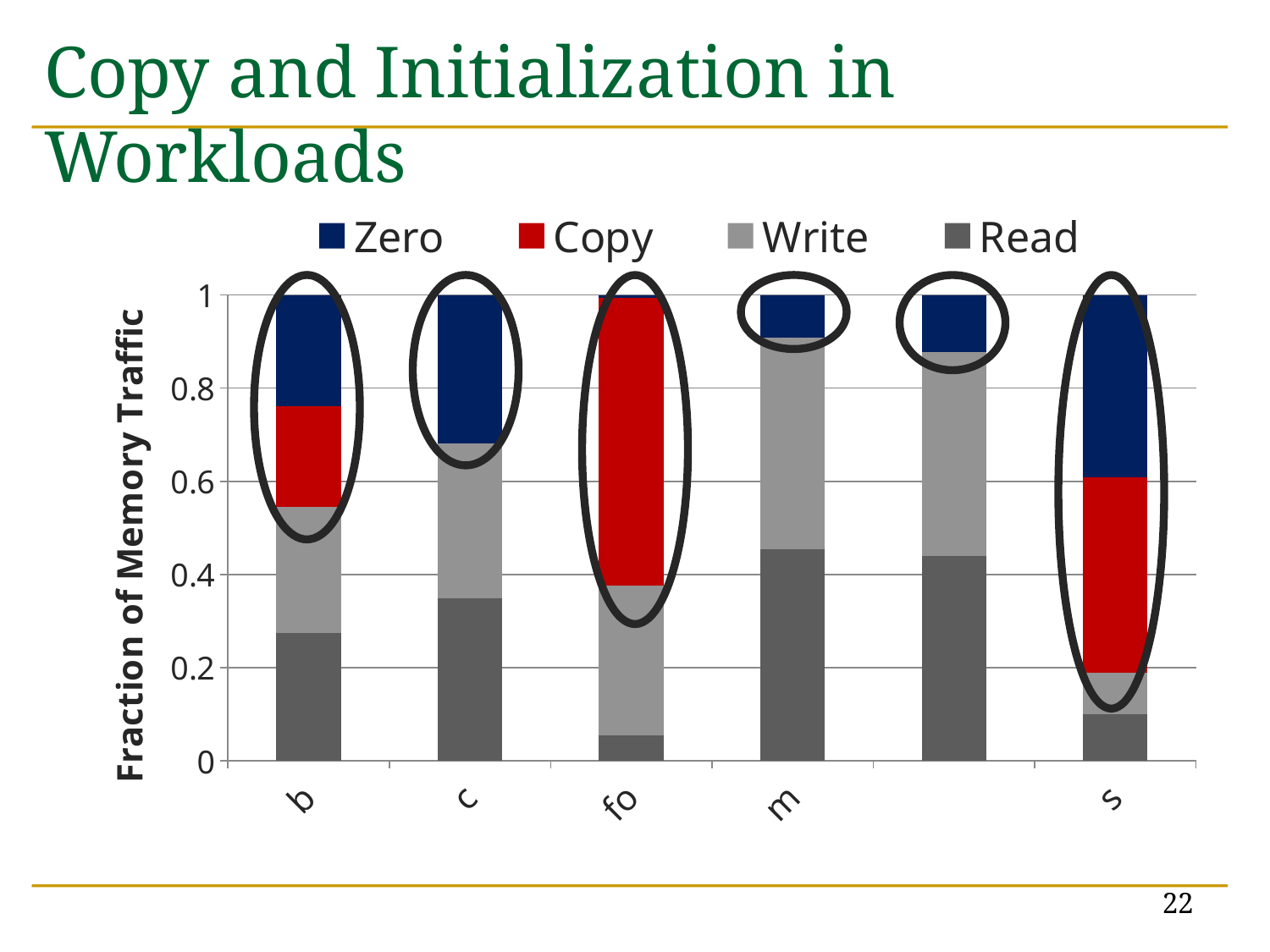
Is the Read value for s greater or less than 0.2? less Which bar has the largest Copy segment? fo Is the Read value for m greater or less than 0.4? greater Which legend entry is shown in red? Copy What kind of chart is shown on the slide? Stacked bar chart How many series does the legend list? 4 Is the Read value for fo greater or less than 0.2? less Which bar has the largest Zero segment? s How many bars are plotted in the chart? 6 What is the label of the y axis? Fraction of Memory Traffic Which has the larger Read segment, b or c? c